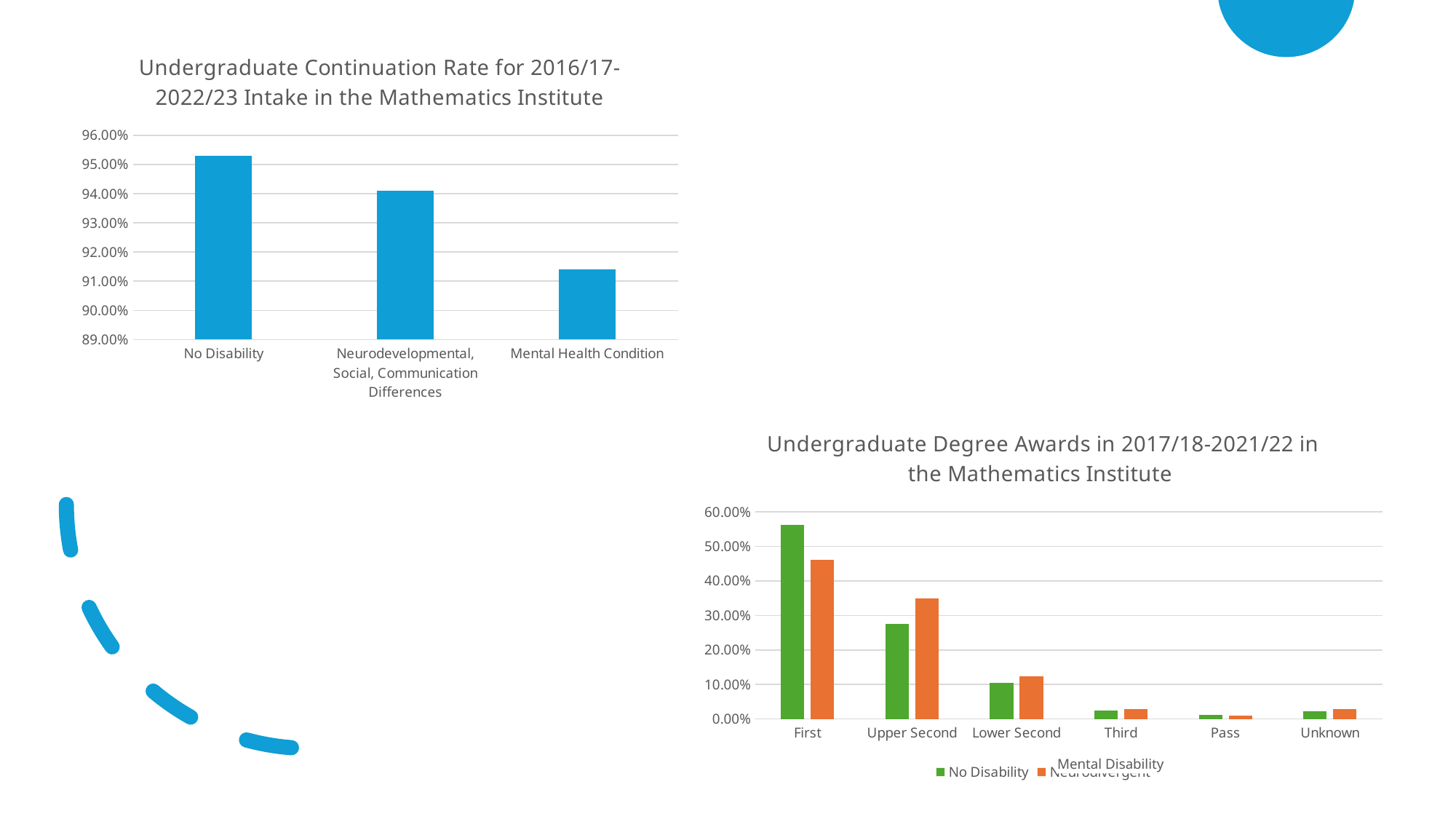
In the 'Undergraduate Degree Awards' chart, which series has the larger value for Upper Second: No Disability or Neurodivergent? Neurodivergent How many degree classification categories are shown on the x axis of the 'Undergraduate Degree Awards in 2017/18-2021/22 in the Mathematics Institute' chart? 6 In the 'Undergraduate Continuation Rate' chart, do the values rise or fall from left to right across the categories? fall How many series does the legend of the 'Undergraduate Degree Awards' chart list? 2 In the 'Undergraduate Continuation Rate' chart, which category has the highest continuation rate? No Disability In the 'Undergraduate Degree Awards' chart, is the No Disability value for First greater or less than 50.00%? greater How many categories are shown in the 'Undergraduate Continuation Rate' chart? 3 In the 'Undergraduate Continuation Rate' chart, which category has the lowest continuation rate? Mental Health Condition In the 'Undergraduate Degree Awards' chart, which series has the larger value for First: No Disability or Neurodivergent? No Disability In the 'Undergraduate Continuation Rate' chart, is the value for Mental Health Condition greater or less than 92.00%? less In the 'Undergraduate Continuation Rate' chart, is the value for No Disability greater or less than 94.00%? greater What kind of chart is the 'Undergraduate Continuation Rate for 2016/17-2022/23 Intake in the Mathematics Institute' chart? bar chart